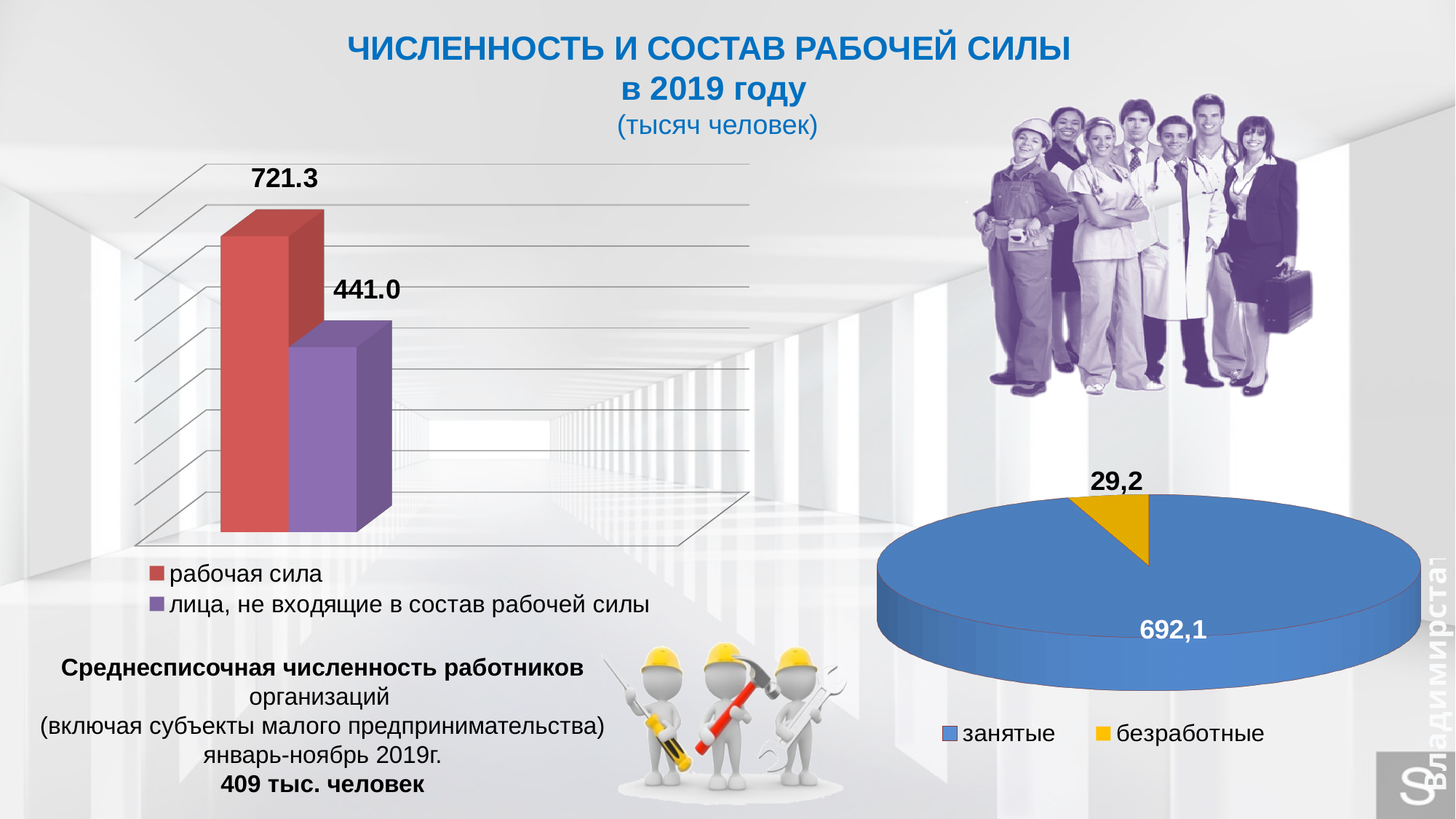
On the bar chart on the left, how many bars are plotted? 2 On the bar chart on the left, which category has the higher value? рабочая сила On the bar chart on the left, which category has the lower value? лица, не входящие в состав рабочей силы On the bar chart on the left, what is the value for рабочая сила? 721.3 On the pie chart on the right, how many entries does the legend list? 2 On the pie chart on the right, what is the value for занятые? 692,1 On the pie chart on the right, what is the total of the two slices? 721,3 On the pie chart on the right, what is the value for безработные? 29,2 On the bar chart on the left, what is the difference between the value for рабочая сила and the value for лица, не входящие в состав рабочей силы? 280.3 On the pie chart on the right, which slice is larger, занятые or безработные? занятые On the bar chart on the left, what is the value for лица, не входящие в состав рабочей силы? 441.0 What kind of chart is shown on the left of the slide? bar chart